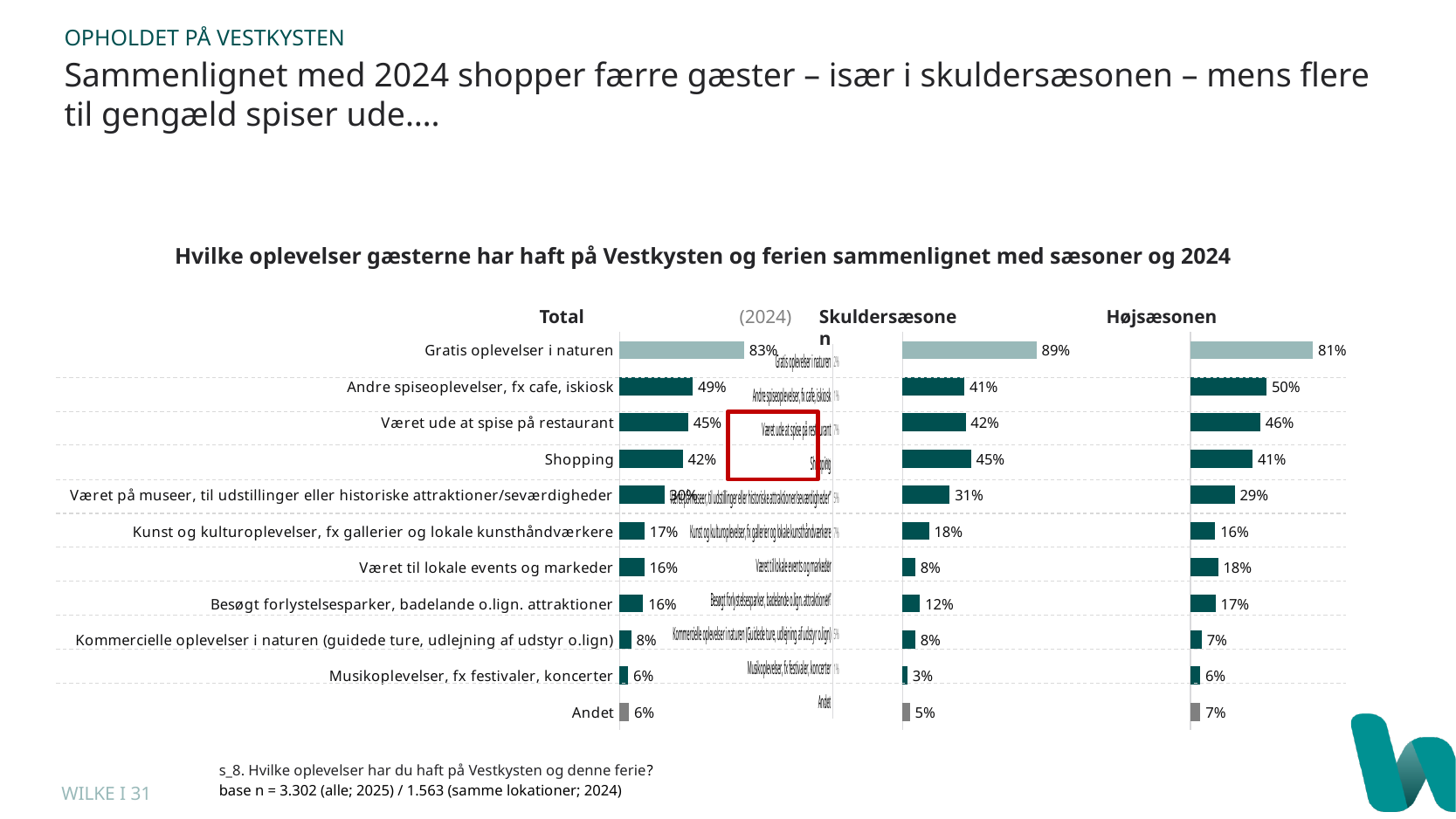
How many categories are shown in the Total chart? 11 In the Skuldersæsonen chart, what is the value for Gratis oplevelser i naturen? 89% What is the difference between the Skuldersæsonen and Højsæsonen values for Været til lokale events og markeder? 10% What is the title of the chart section on the slide? Hvilke oplevelser gæsterne har haft på Vestkysten og ferien sammenlignet med sæsoner og 2024 In the Højsæsonen chart, what is the value for Andre spiseoplevelser, fx cafe, iskiosk? 50% What kind of chart is used for the Højsæsonen data? bar chart In the Skuldersæsonen chart, which category has the lowest value? Musikoplevelser, fx festivaler, koncerter In the Skuldersæsonen chart, what is the value for Musikoplevelser, fx festivaler, koncerter? 3% In the Højsæsonen chart, which category has the highest value? Gratis oplevelser i naturen In the Total chart, what is the value for Shopping? 42% In the Total chart, is the value for Været ude at spise på restaurant larger or smaller than the value for Andre spiseoplevelser, fx cafe, iskiosk? smaller Is the value for Shopping larger in the Skuldersæsonen chart or the Højsæsonen chart? Skuldersæsonen